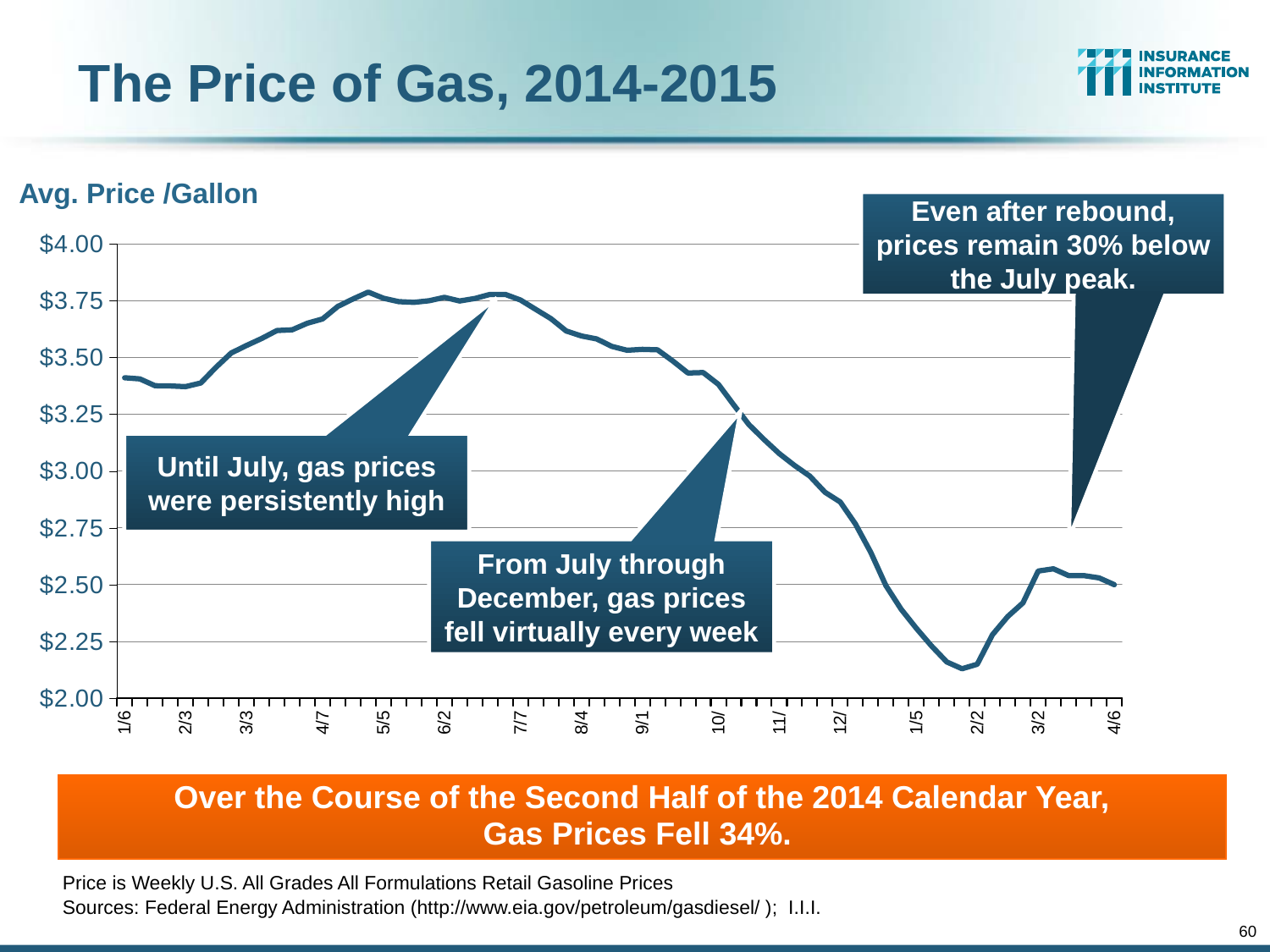
Do gas prices rise or fall between 1/6 and 5/5? rise Is the value for 1/6 greater or less than $3.25? greater Which is larger, the value for 5/5 or the value for 2/2? 5/5 Do gas prices rise or fall between 7/7 and 12/? fall Which is larger, the value for 1/6 or the value for 4/6? 1/6 What is the label on the y axis of the chart? Avg. Price /Gallon Is the value for 2/2 greater or less than $2.25? less Is the value for 1/5 greater or less than $2.50? less What kind of chart is shown on the slide? Line chart According to the callout on the chart, by what percentage do prices remain below the July peak even after the rebound? 30%